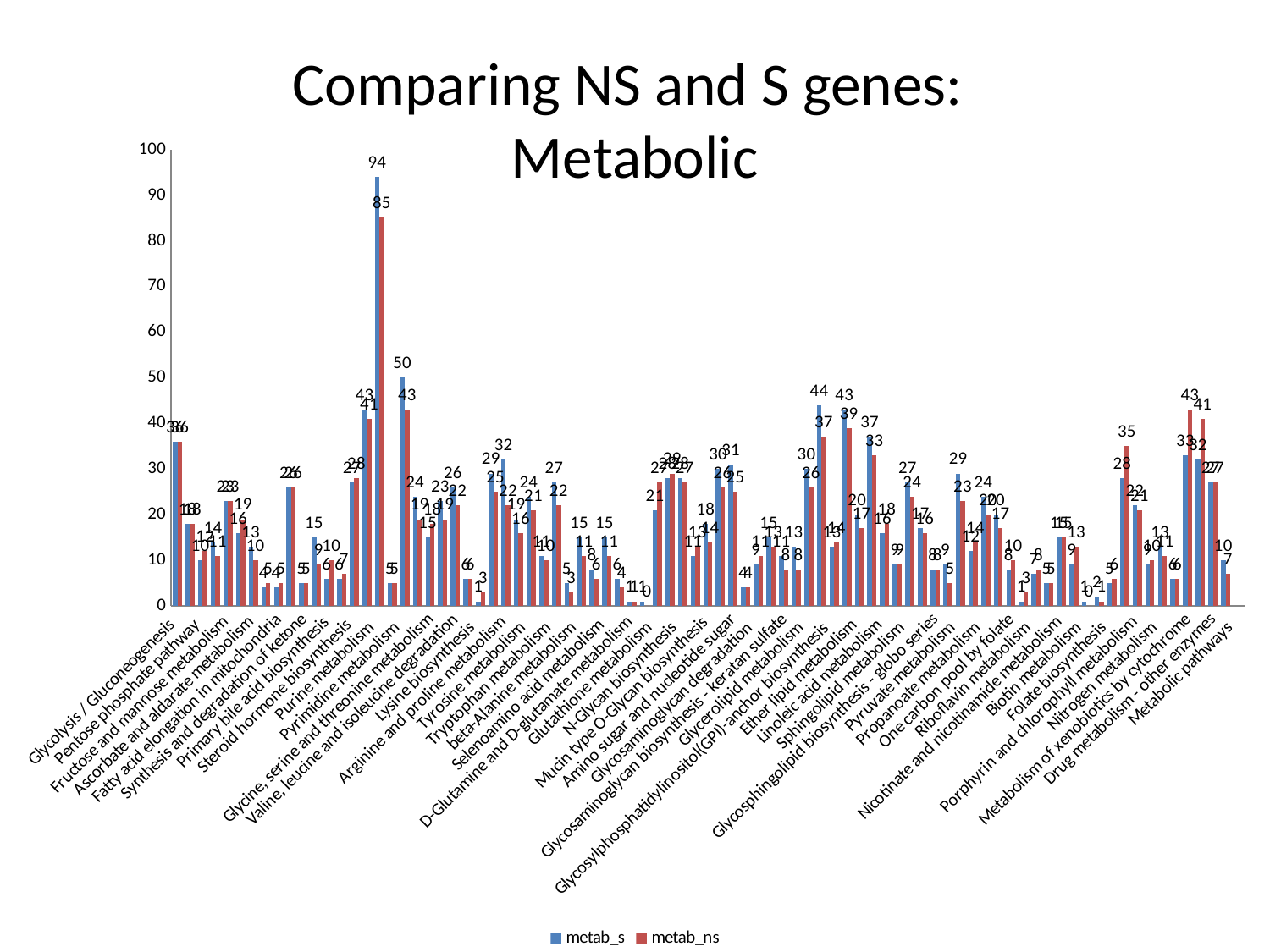
What is the highest value plotted for the metab_s series? 94 What is the metab_s value for Glycolysis / Gluconeogenesis? 36 What is the metab_ns value for Glycolysis / Gluconeogenesis? 36 What is the highest value plotted for the metab_ns series? 85 What are the two series named in the legend? metab_s and metab_ns Is the tallest bar on the chart greater or less than 90? greater What is the title of the chart? Comparing NS and S genes: Metabolic How many series does the legend list? 2 What is the maximum value shown on the vertical axis? 100 What is the difference between the tallest metab_s bar (94) and the tallest metab_ns bar (85)? 9 What is the difference between the metab_s and metab_ns values for Glycolysis / Gluconeogenesis? 0 What kind of chart is shown on the slide? bar chart